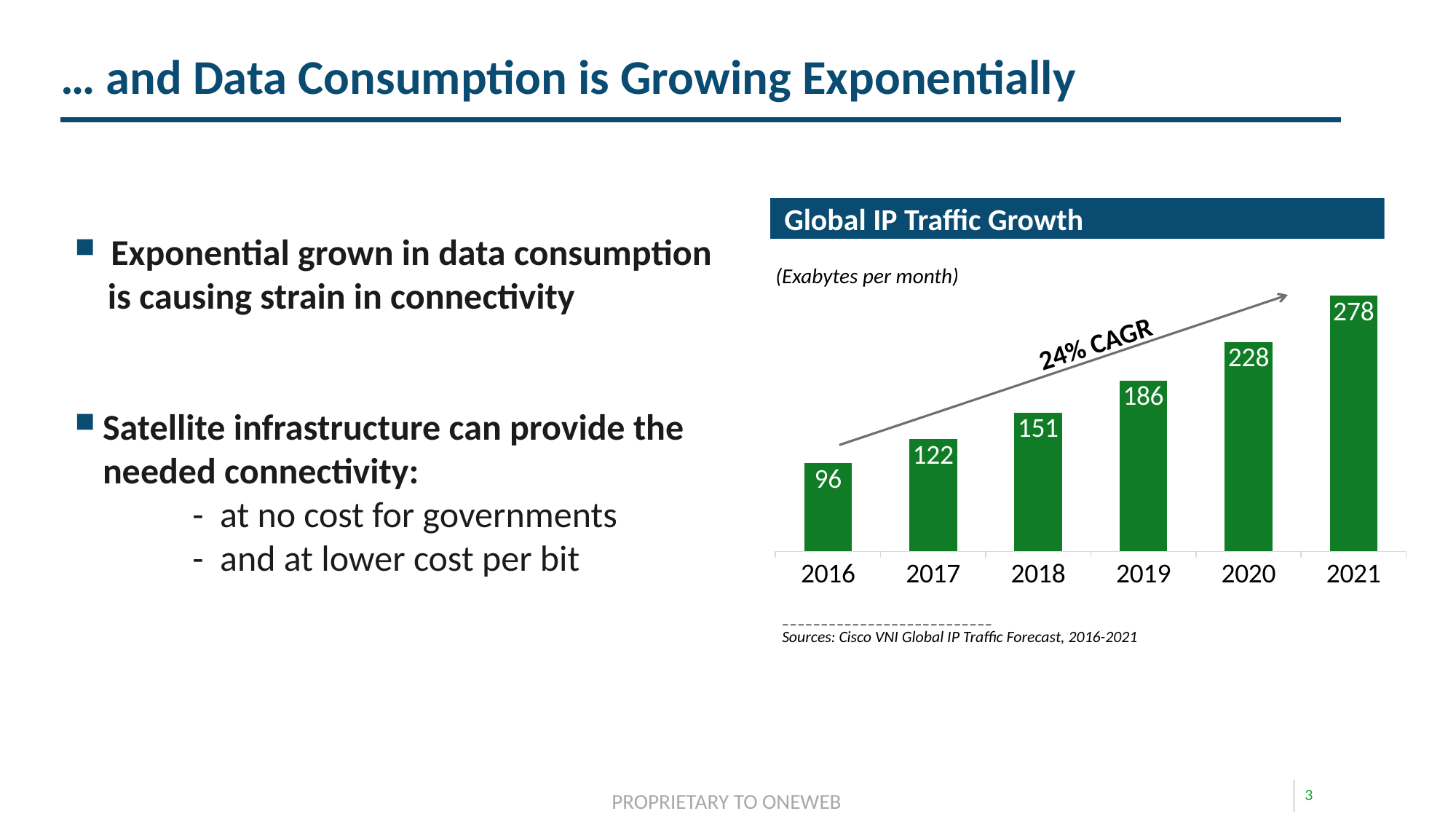
What CAGR is annotated on the Global IP Traffic Growth chart? 24% CAGR What is the value for 2016 in the Global IP Traffic Growth chart? 96 Which year has the lowest value in the Global IP Traffic Growth chart? 2016 What kind of chart is the Global IP Traffic Growth chart? bar chart What is the value for 2021 in the Global IP Traffic Growth chart? 278 How many years are shown in the Global IP Traffic Growth chart? 6 What is the difference between the 2018 and 2017 values in the Global IP Traffic Growth chart? 29 What is the value for 2019 in the Global IP Traffic Growth chart? 186 What is the difference between the 2021 and 2016 values in the Global IP Traffic Growth chart? 182 Do the values in the Global IP Traffic Growth chart rise or fall from 2016 to 2021? rise Which year has the highest value in the Global IP Traffic Growth chart? 2021 Which is larger in the Global IP Traffic Growth chart, the value for 2020 or the value for 2019? 2020